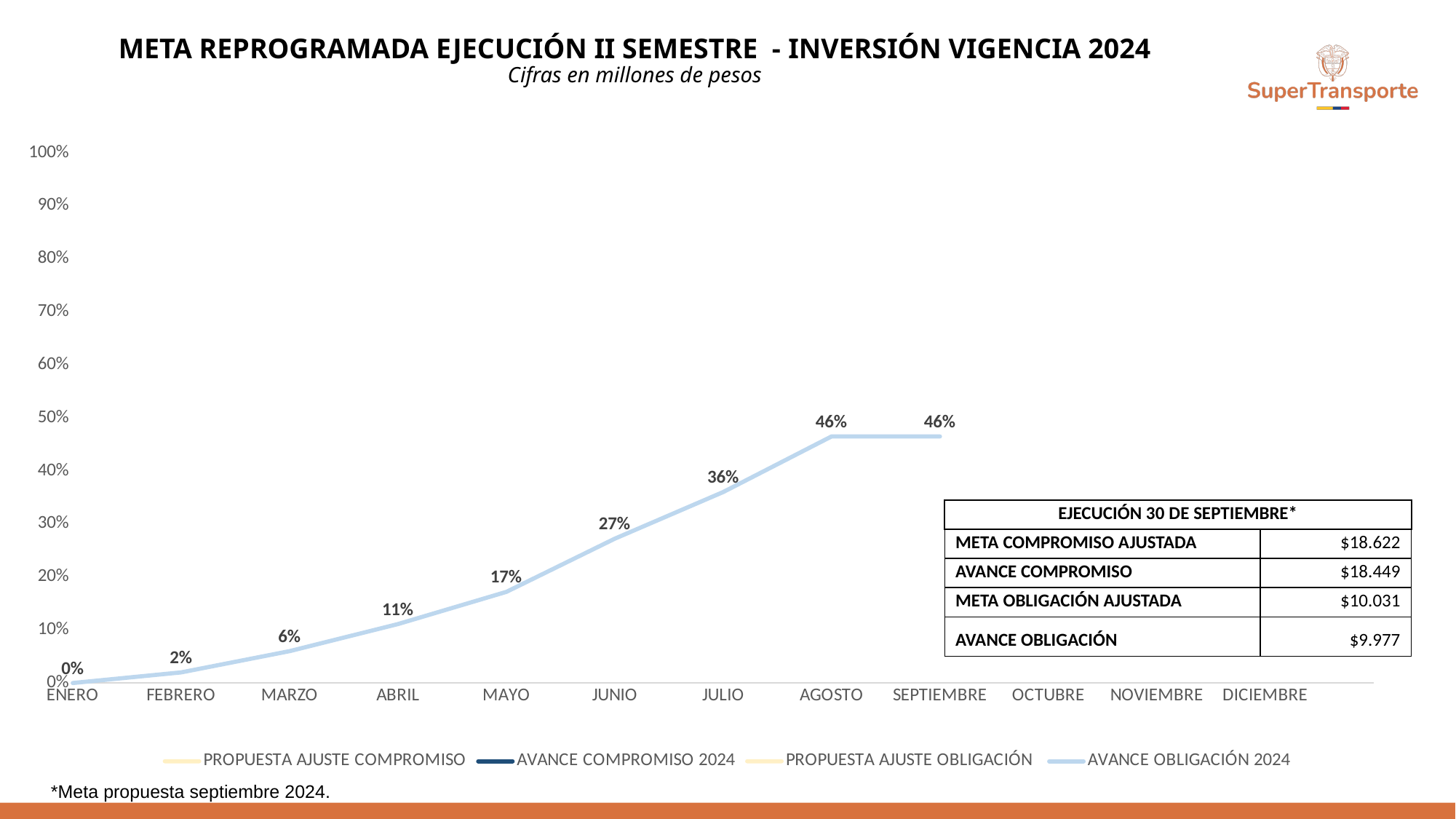
What is the value for SEPTIEMBRE on the chart? 46% Which month has the lowest plotted value? ENERO What is the difference between the values for JULIO and MAYO? 19% What is the value for MARZO on the chart? 6% How many months are shown on the x axis? 12 What is the value for JUNIO on the chart? 27% What is the value for ABRIL on the chart? 11% Which is larger, the value for MAYO or the value for FEBRERO? MAYO What kind of chart is shown on the slide? Line chart What is the difference between the values for AGOSTO and JUNIO? 19% Do the plotted values rise or fall from ENERO to AGOSTO? Rise How many series does the legend list? 4